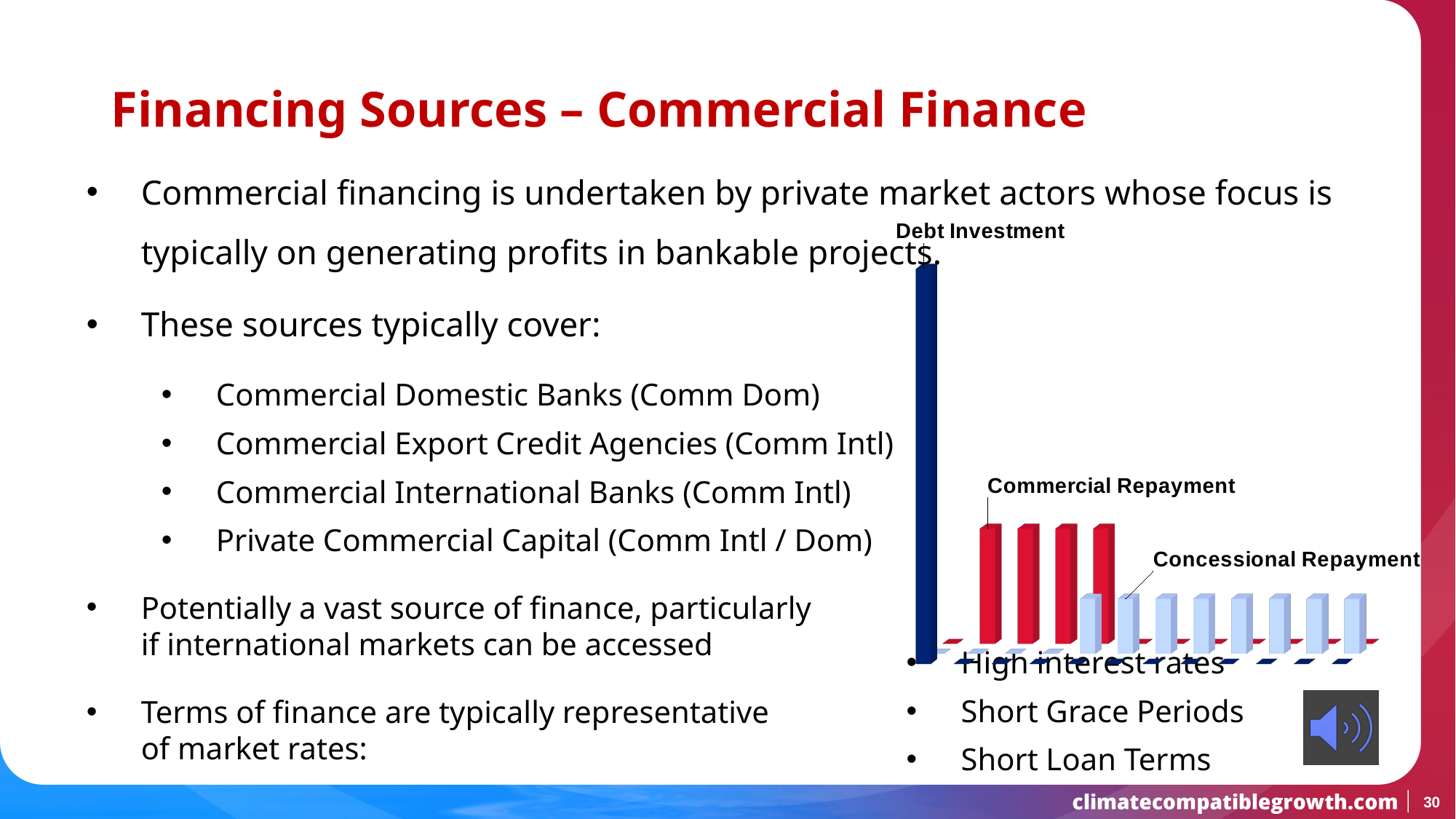
Which is taller, the Debt Investment bar or a Commercial Repayment bar? Debt Investment Do the Commercial Repayment bars rise, fall, or stay level from left to right? stay level What colour is the Debt Investment bar? dark blue Which labelled bar in the chart is the tallest? Debt Investment Which bars are taller, the Commercial Repayment bars or the Concessional Repayment bars? Commercial Repayment How many bars are labelled Concessional Repayment? 8 How many Debt Investment bars are shown? 1 What colour are the Commercial Repayment bars? red Which labelled group of bars is the shortest? Concessional Repayment What kind of chart is shown on the slide? bar chart How many bars are labelled Commercial Repayment? 4 Do the Concessional Repayment bars rise, fall, or stay level from left to right? stay level